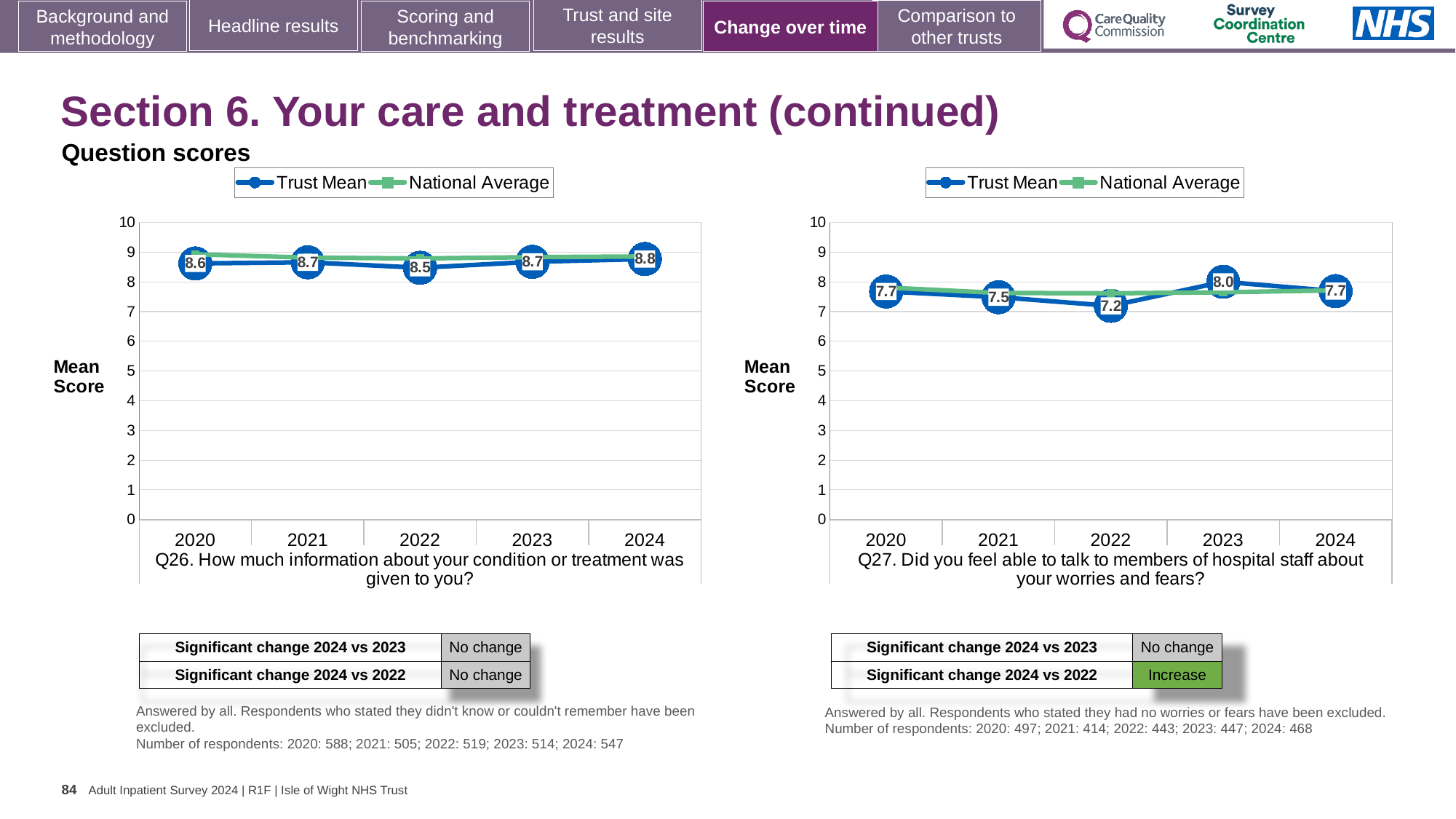
In the Q27 chart, what is the Trust Mean score for 2022? 7.2 In the Q27 chart, which year has the highest Trust Mean score? 2023 In the Q26 chart, what is the Trust Mean score for 2024? 8.8 In the Q27 chart, what is the difference between the Trust Mean scores for 2023 and 2022? 0.8 In the Q27 chart, which year has the lowest Trust Mean score? 2022 In the Q26 chart, is the Trust Mean score for 2021 or 2022 higher? 2021 What type of chart is the Q26 chart? Line chart How many series does the legend of the Q26 chart list? 2 In the Q27 chart, what is the Trust Mean score for 2023? 8.0 In the Q26 chart, which year has the highest Trust Mean score? 2024 In the Q26 chart, what is the Trust Mean score for 2022? 8.5 How many years are plotted on the x axis of the Q27 chart? 5